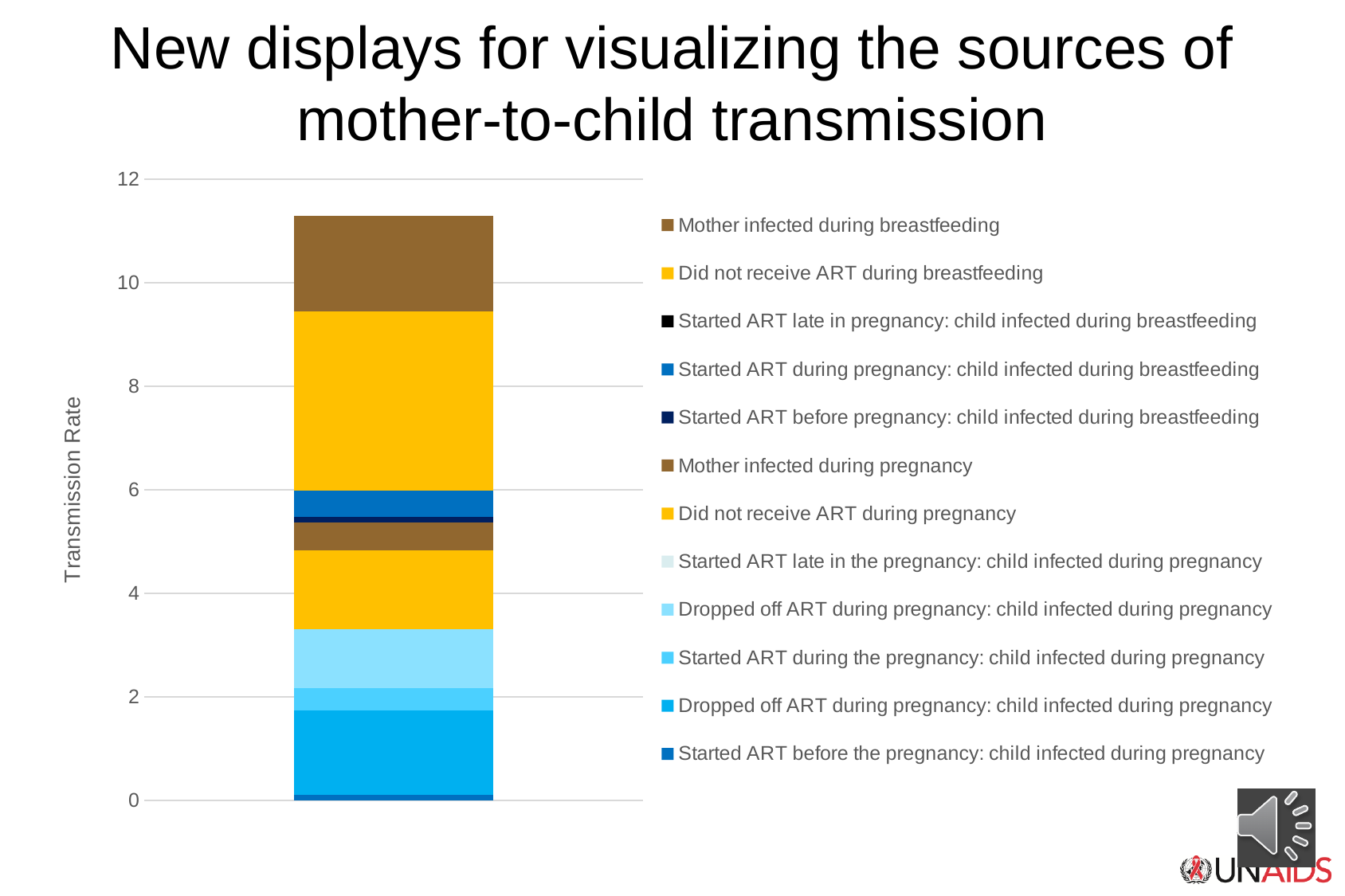
Which segment is larger: 'Mother infected during breastfeeding' or 'Mother infected during pregnancy'? Mother infected during breastfeeding How many bars are plotted in the chart? 1 Which segment is larger: 'Did not receive ART during breastfeeding' or 'Did not receive ART during pregnancy'? Did not receive ART during breastfeeding What is the highest value shown on the vertical axis? 12 How many series does the legend list? 12 Which series is listed first in the legend? Mother infected during breastfeeding Is the total height of the stacked bar greater or less than 12? less Is the total height of the stacked bar greater or less than 10? greater Which series contributes the largest segment to the stacked bar? Did not receive ART during breastfeeding What kind of chart is shown on the slide? Stacked bar chart What is the label of the vertical axis? Transmission Rate